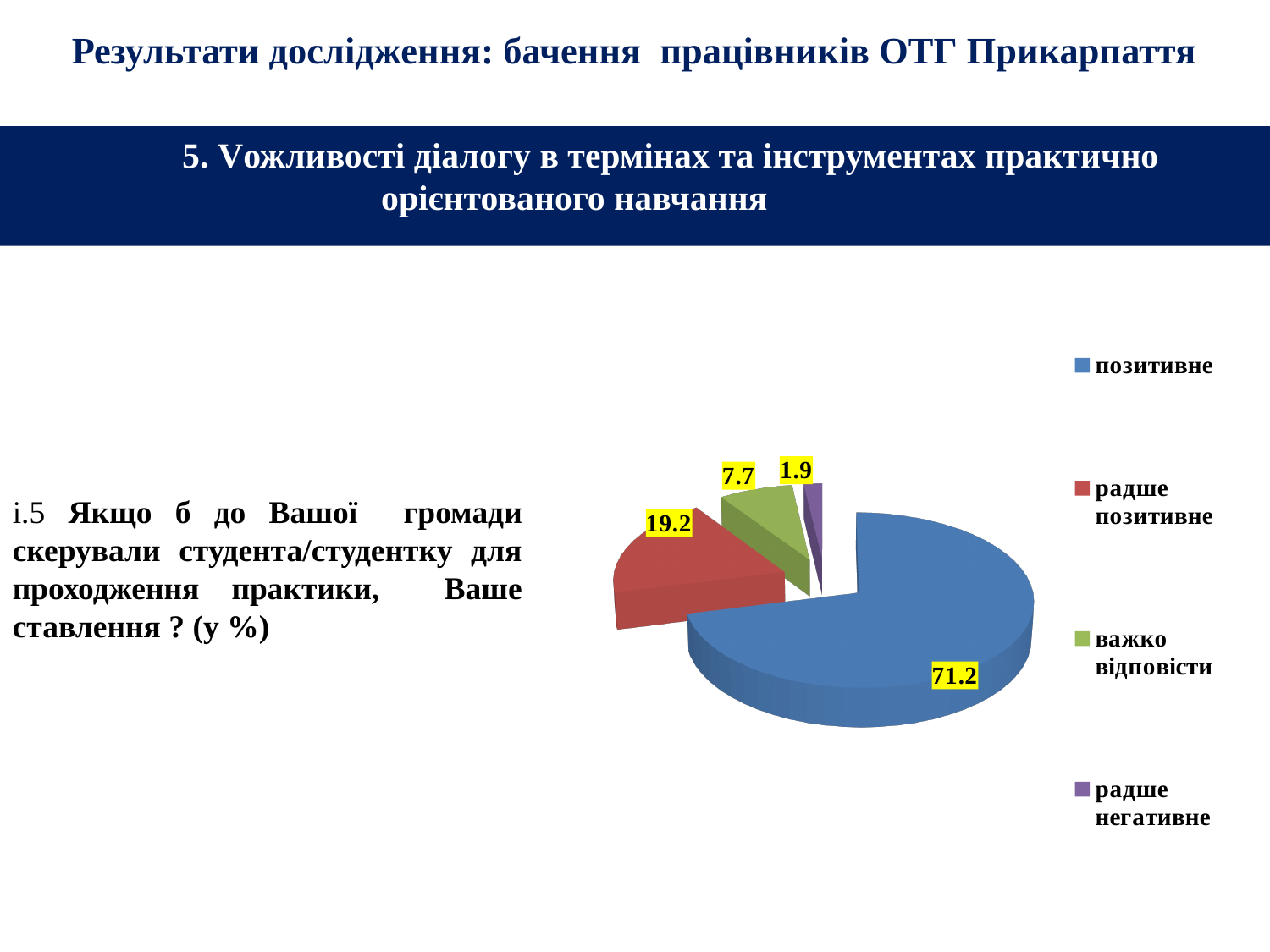
What type of chart is shown on the slide? pie chart What is the value for "радше негативне" in the pie chart? 1.9 Which category has the smallest slice in the pie chart? радше негативне Which is larger: the value for "радше позитивне" or the value for "важко відповісти"? радше позитивне What is the value for "важко відповісти" in the pie chart? 7.7 What is the value for "радше позитивне" in the pie chart? 19.2 What is the difference between the values for "позитивне" and "радше позитивне"? 52 Which category has the largest slice in the pie chart? позитивне What colour is the slice for "позитивне" in the pie chart? blue How many categories does the pie chart show? 4 What is the value for "позитивне" in the pie chart? 71.2 What is the difference between the values for "важко відповісти" and "радше негативне"? 5.8